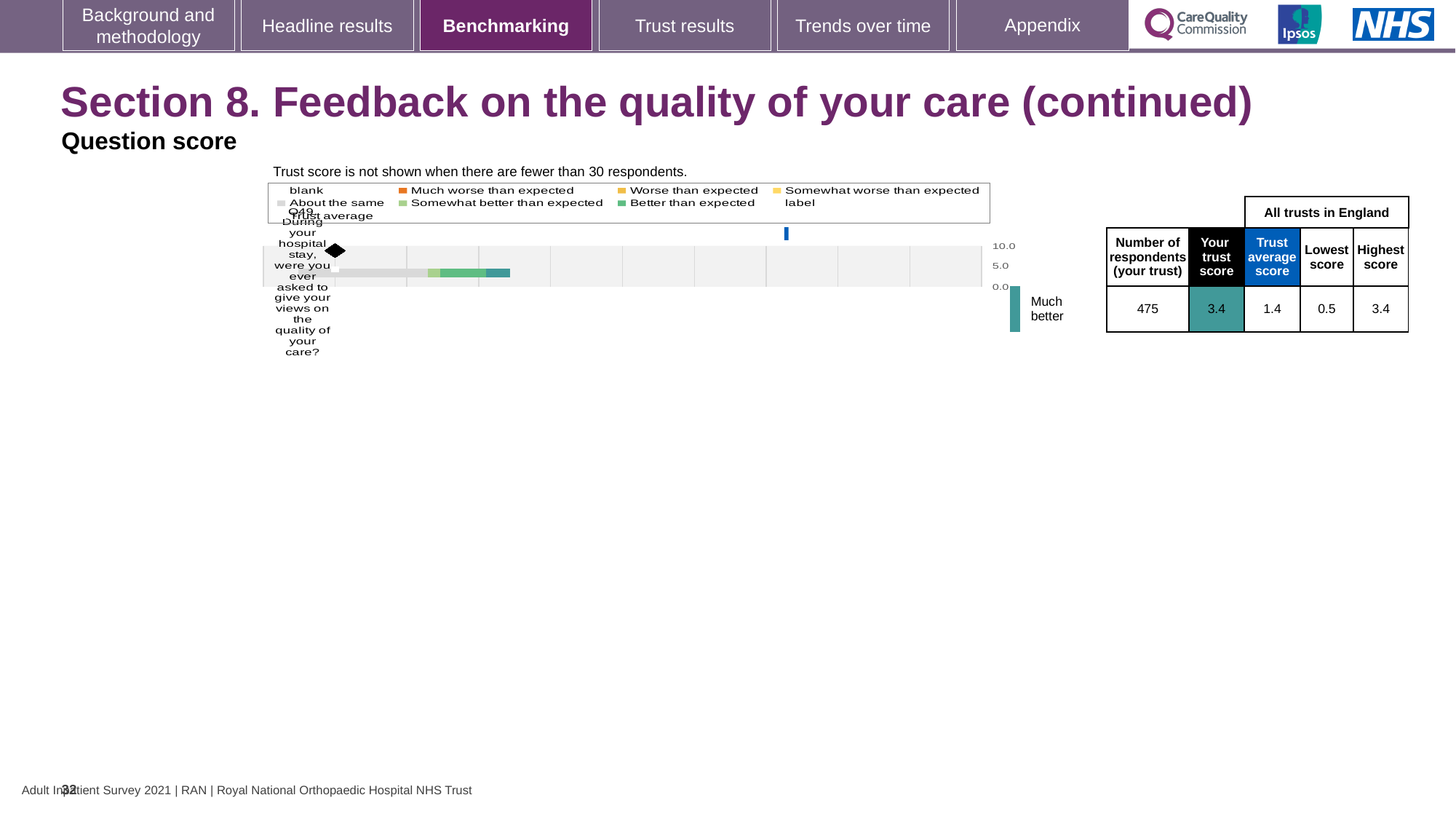
What is the number of respondents for your trust for Q49? 475 Which is larger for Q49: your trust score or the trust average score? Your trust score What label appears next to the small bar at the right of the chart? Much better What is the difference between the highest and lowest scores for Q49 across all trusts in England? 2.9 What is the trust average score for Q49 across all trusts in England? 1.4 Which question number is plotted in the benchmarking chart? Q49 What is the highest score for Q49 across all trusts in England? 3.4 What kind of chart is used to show the Q49 benchmarking result? Bar chart By how much does your trust score for Q49 exceed the trust average score? 2.0 What is the lowest score for Q49 across all trusts in England? 0.5 What is your trust score for Q49? 3.4 How many questions are plotted in the benchmarking chart? 1